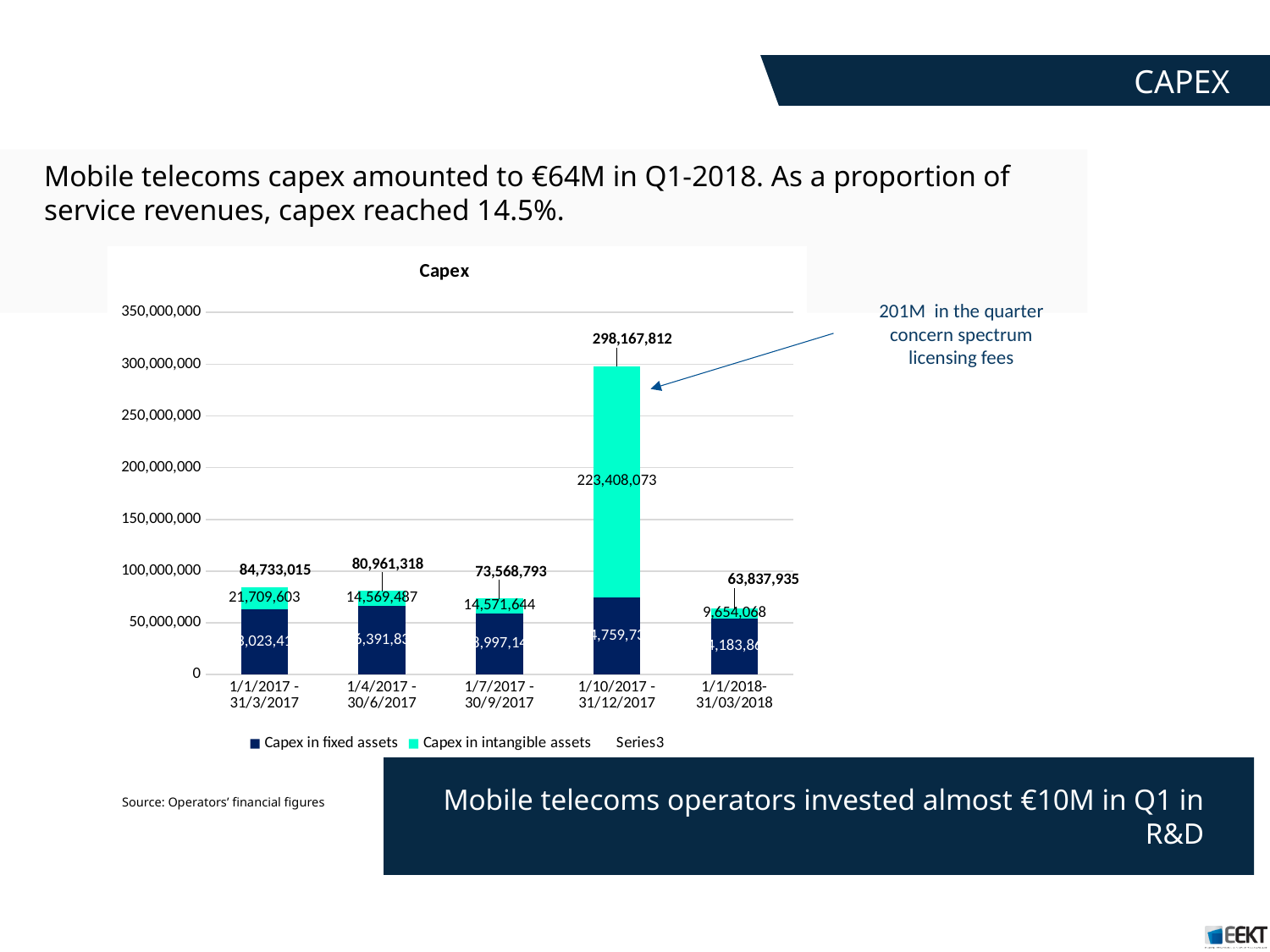
Is the total capex for 1/10/2017 - 31/12/2017 greater or less than 250,000,000? greater What is the title of the chart? Capex Which period has the lowest total capex? 1/1/2018-31/03/2018 How many entries does the legend of the Capex chart list? 3 What is the value of capex in intangible assets for the period 1/1/2018-31/03/2018? 9,654,068 How many quarters (categories) are plotted on the x axis of the Capex chart? 5 What type of chart is shown on the slide? bar chart Which period has the highest total capex? 1/10/2017 - 31/12/2017 Which period has the larger capex in intangible assets: 1/1/2017 - 31/3/2017 or 1/1/2018-31/03/2018? 1/1/2017 - 31/3/2017 What is the total capex shown for the period 1/10/2017 - 31/12/2017? 298,167,812 What is the value of capex in intangible assets for the period 1/10/2017 - 31/12/2017? 223,408,073 What is the difference between the total capex for 1/1/2017 - 31/3/2017 and the total capex for 1/1/2018-31/03/2018? 20,895,080